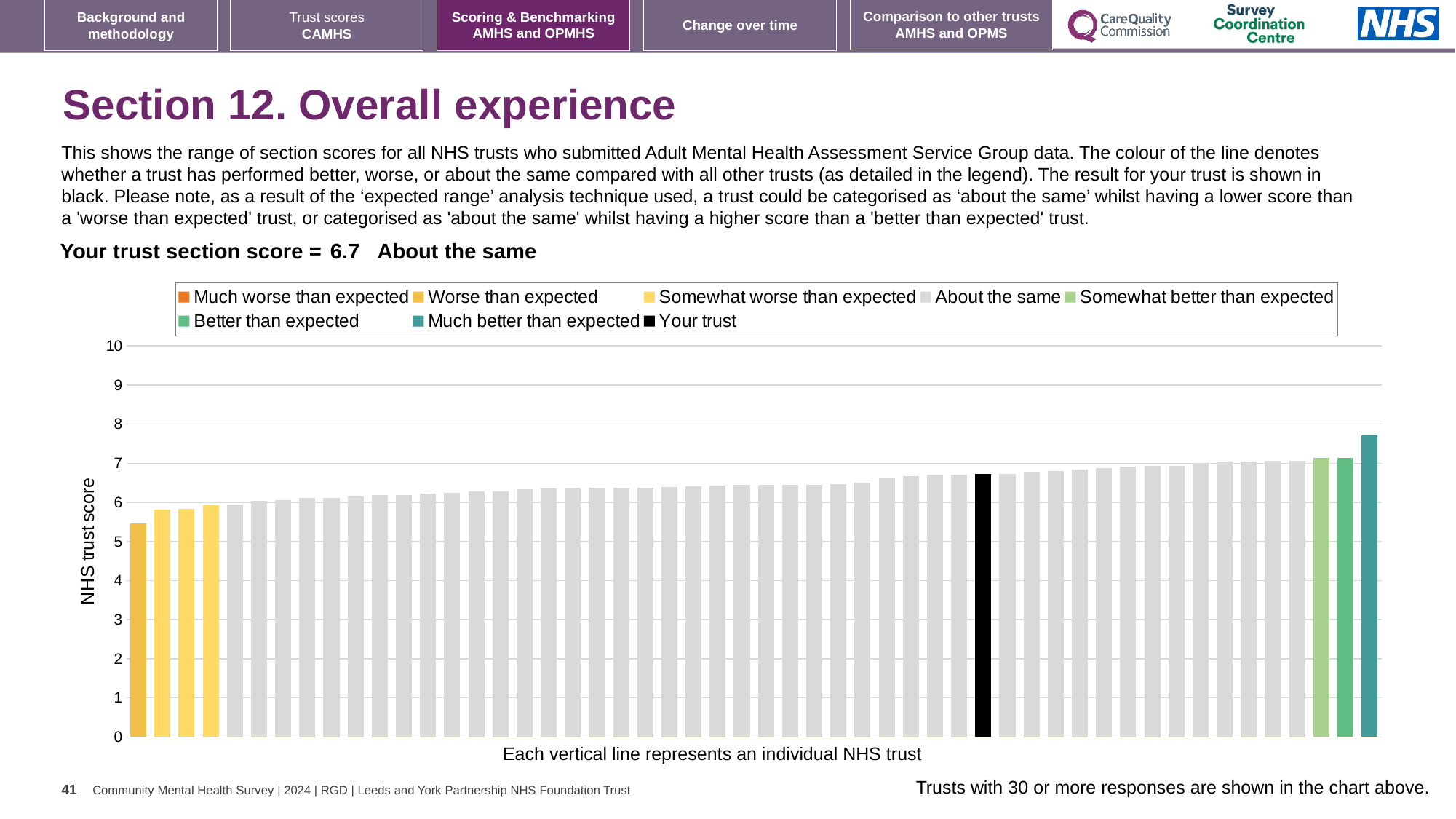
Which legend category does the highest bar belong to? Much better than expected Is the value of the lowest bar (leftmost trust) greater or less than 6? less What colour is the bar representing your trust? black Is the value for your trust greater or less than 7? less How many bars are coloured as 'Worse than expected'? 1 Which legend category does the lowest bar belong to? Worse than expected What kind of chart is shown on the slide? bar chart What is the section score for your trust? 6.7 Is the value of the highest bar (rightmost trust) greater or less than 7? greater Do the bar values rise or fall from left to right along the x axis? rise How many entries does the chart legend list? 8